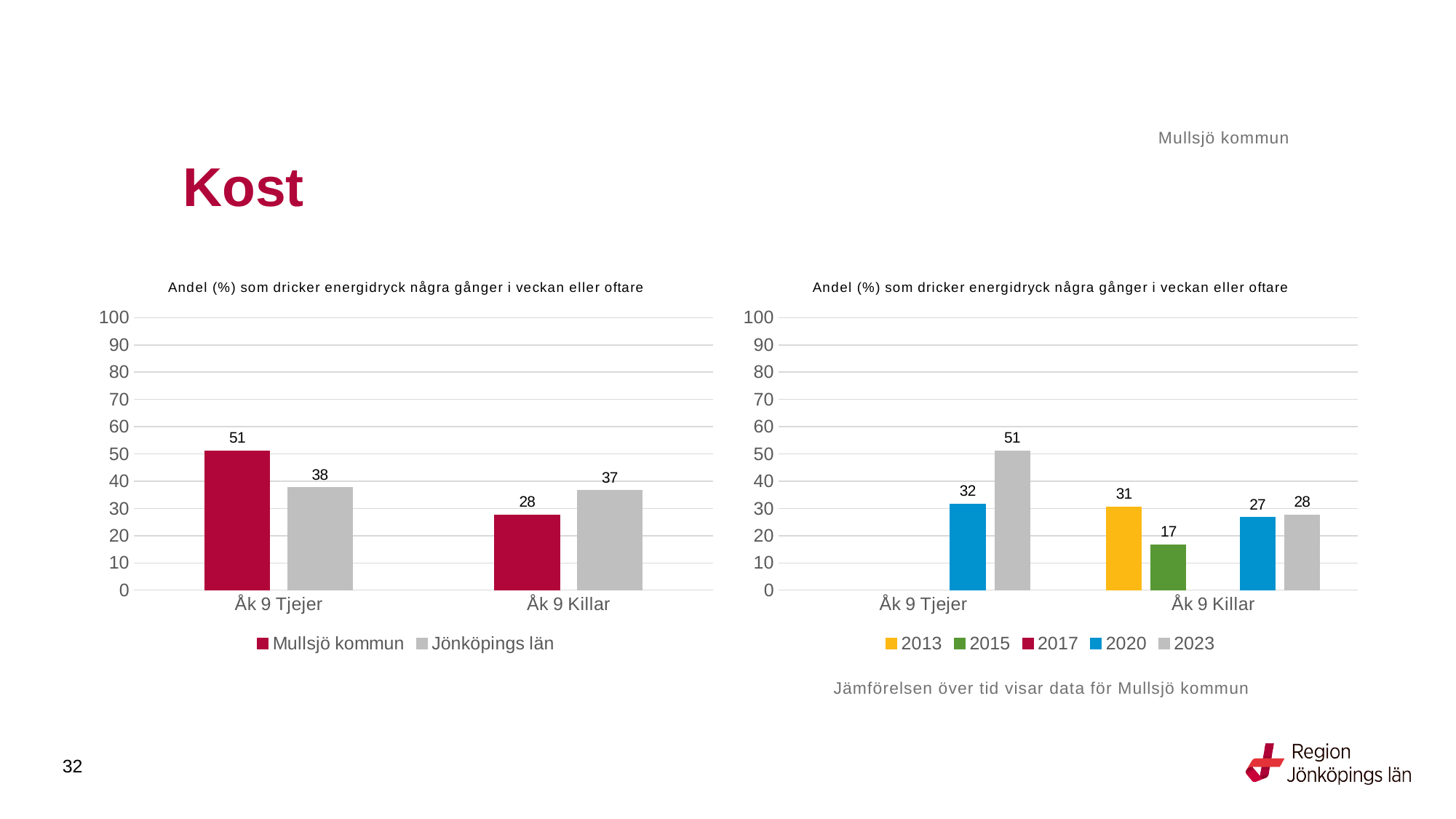
In the right chart, which year has the lowest value for Åk 9 Killar? 2015 What kind of chart is the left chart? Bar chart In the right chart, what is the value for 2023 for Åk 9 Tjejer? 51 In the right chart, what is the difference between 2023 and 2020 for Åk 9 Tjejer? 19 In the right chart, what is the value for 2015 for Åk 9 Killar? 17 In the left chart, what is the value for Mullsjö kommun for Åk 9 Tjejer? 51 In the left chart, how many series does the legend list? 2 In the right chart, which year is shown in yellow in the legend? 2013 In the left chart, what is the value for Jönköpings län for Åk 9 Killar? 37 In the right chart, how many series does the legend list? 5 In the left chart, what is the difference between Mullsjö kommun and Jönköpings län for Åk 9 Tjejer? 13 In the left chart, which is larger for Åk 9 Killar: Mullsjö kommun or Jönköpings län? Jönköpings län